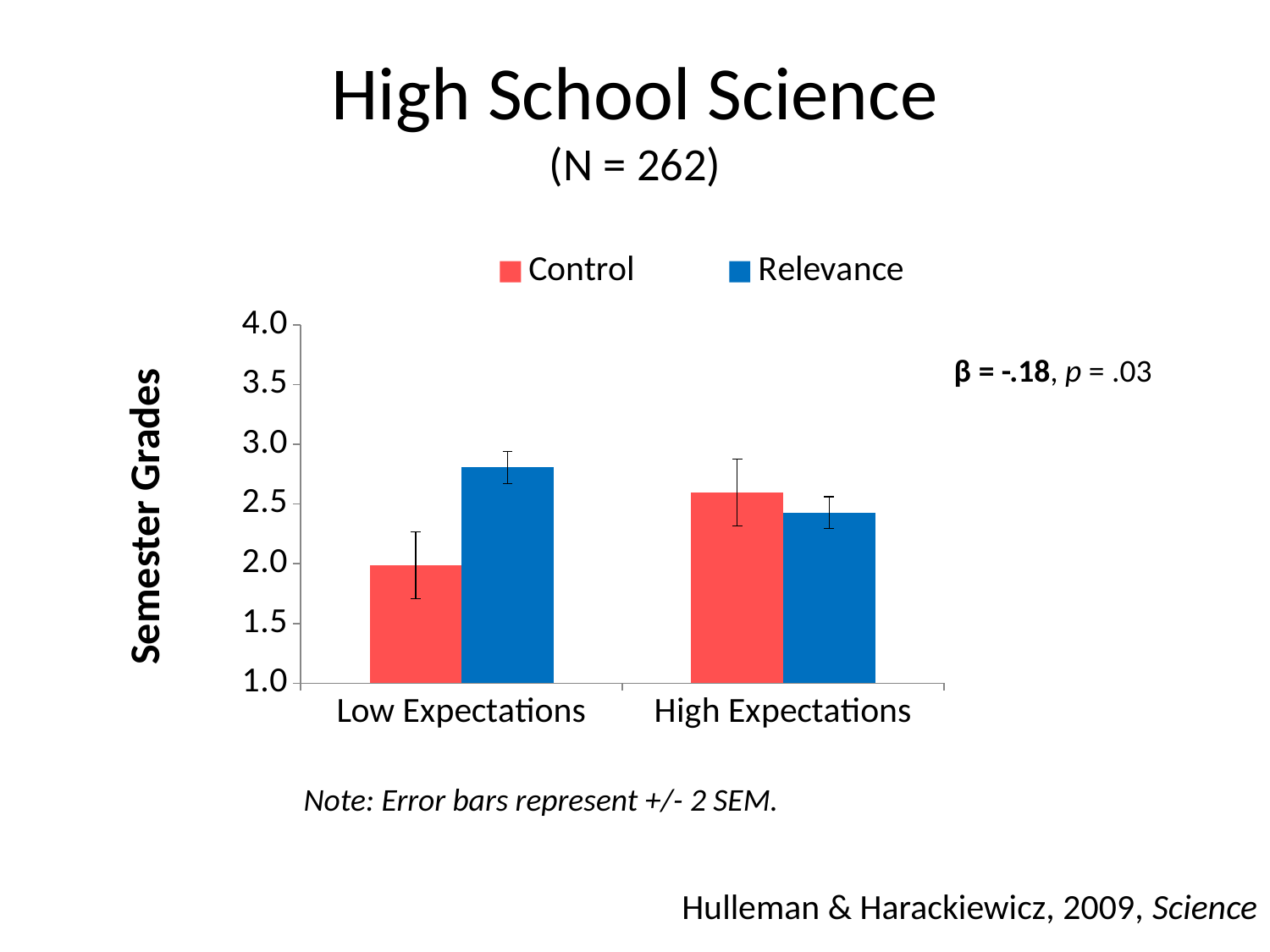
Which bar is the tallest in the chart? Relevance, Low Expectations What kind of chart is shown on the slide? bar chart How many series does the legend list? 2 How many categories are shown on the x axis? 2 Is the Control value for Low Expectations greater or less than 2.5? less Which bar is the shortest in the chart? Control, Low Expectations Is the Control value for High Expectations greater or less than 3.0? less Which series has the higher bar for High Expectations, Control or Relevance? Control Which colour represents the Relevance series in the legend? blue Is the Relevance value for Low Expectations greater or less than 2.5? greater Which series has the higher bar for Low Expectations, Control or Relevance? Relevance What is the label on the y axis? Semester Grades